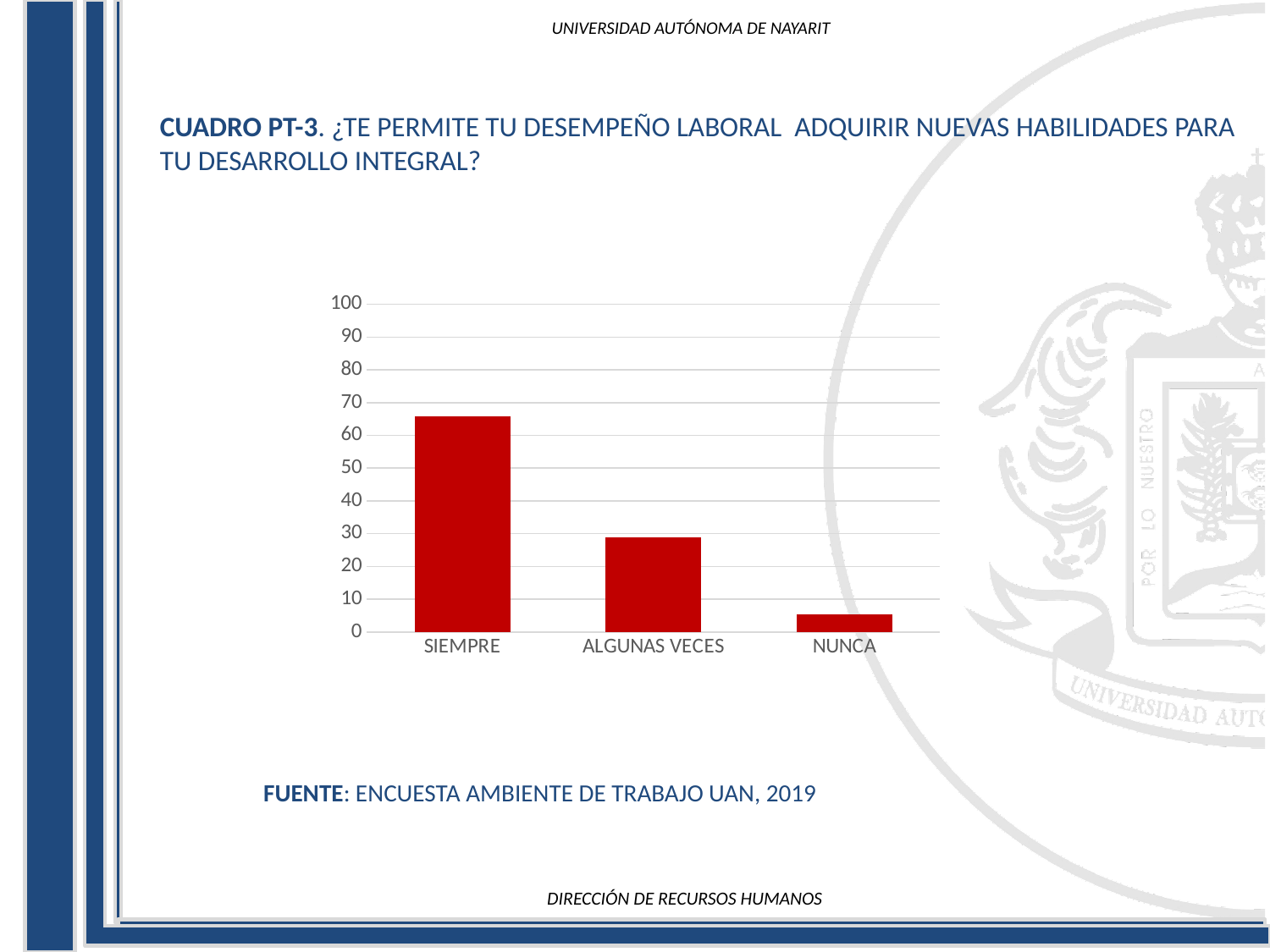
Is the value for SIEMPRE greater or less than 60? greater What is the maximum value shown on the vertical axis of the chart? 100 What kind of chart is shown on the slide? bar chart Is the value for SIEMPRE greater or less than 70? less How many categories are shown on the x axis of the chart? 3 Do the bar values rise or fall from left to right along the x axis? fall Which category has the highest bar in the chart? SIEMPRE Which category has the lowest bar in the chart? NUNCA Is the value for NUNCA greater or less than 10? less Which is larger, the value for SIEMPRE or the value for ALGUNAS VECES? SIEMPRE